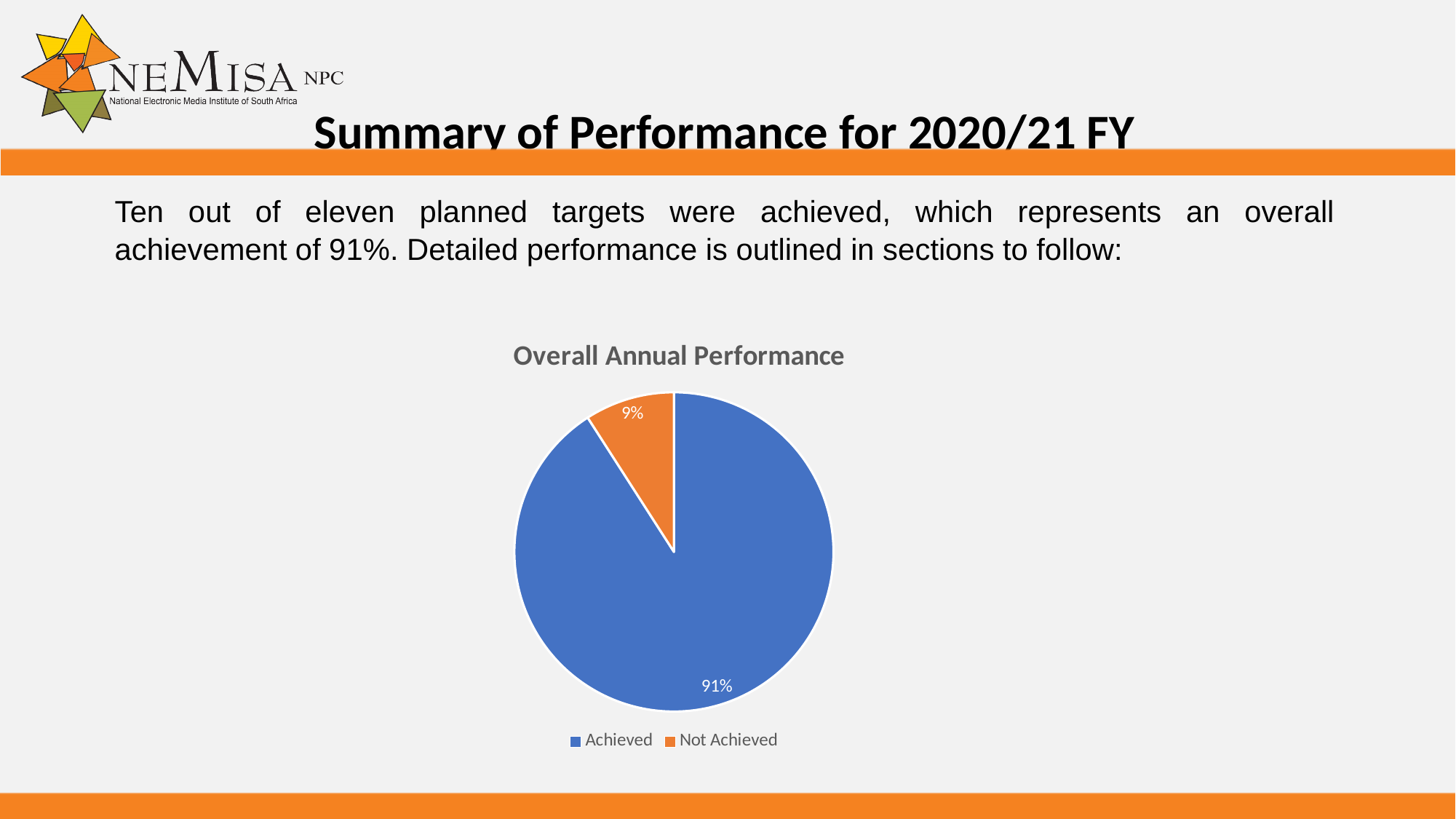
How many entries does the legend list? 2 What share of the pie is labelled Achieved? 91% How many slices does the pie chart have? 2 What colour is the Not Achieved slice? orange What is the title of the chart? Overall Annual Performance What type of chart is shown on the slide? pie chart What is the difference in percentage points between the Achieved and Not Achieved slices? 82 Which slice of the pie is the smallest? Not Achieved Which is larger, the Achieved slice or the Not Achieved slice? Achieved What share of the pie is labelled Not Achieved? 9% Which slice of the pie is the largest? Achieved